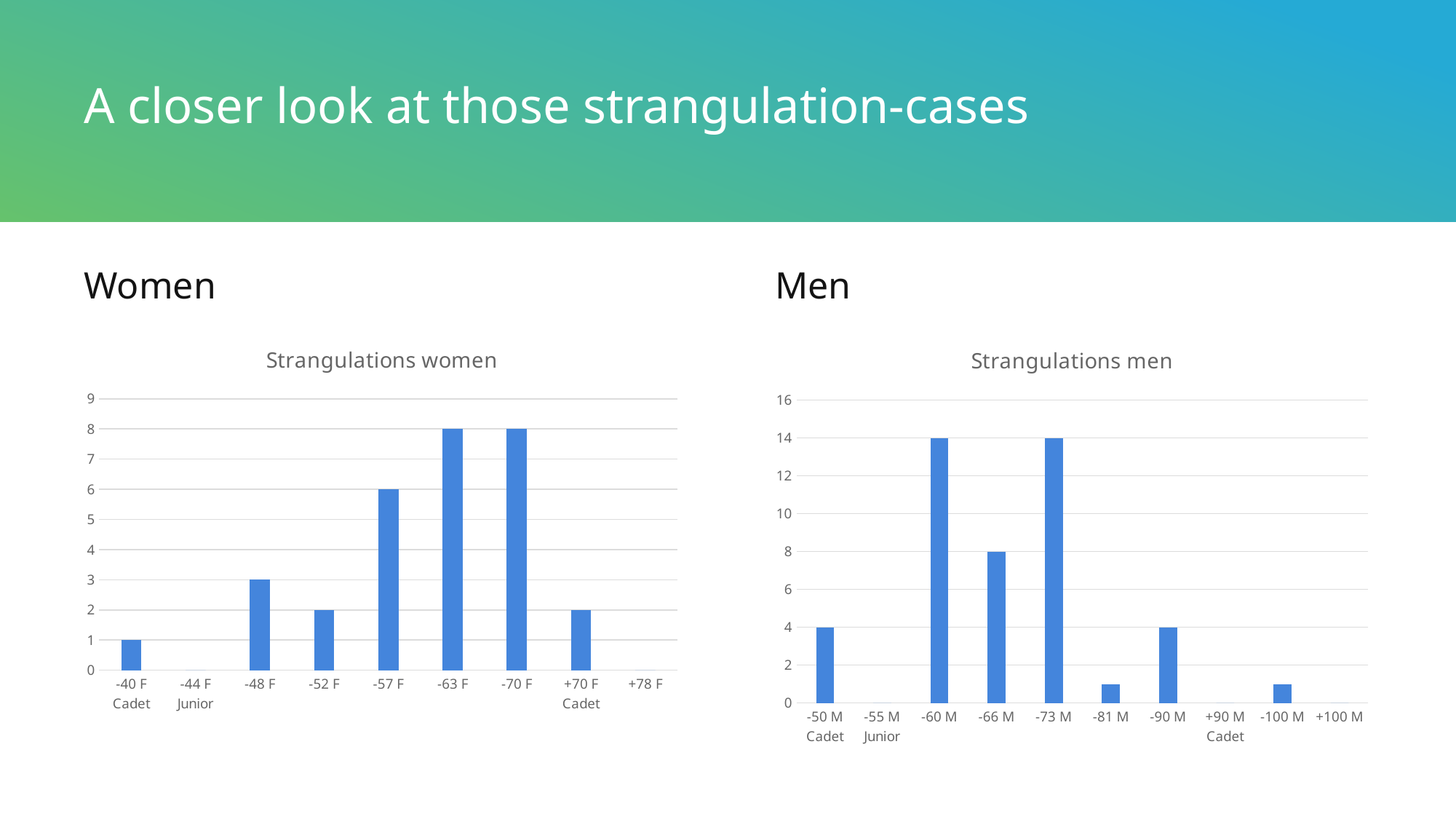
In the Strangulations women chart, what is the difference between the values for -63 F and -57 F? 2 In the Strangulations men chart, which is larger, the value for -60 M or the value for -66 M? -60 M In the Strangulations men chart, what is the difference between the values for -73 M and -90 M? 10 In the Strangulations men chart, what is the value for -66 M? 8 In the Strangulations men chart, is the value for -81 M greater or less than 2? less In the Strangulations men chart, what is the value for -50 M Cadet? 4 In the Strangulations men chart, how many categories are shown on the x axis? 10 In the Strangulations women chart, which category has the lowest non-zero value? -40 F Cadet In the Strangulations women chart, how many categories are shown on the x axis? 9 In the Strangulations women chart, what is the value for -57 F? 6 In the Strangulations women chart, what is the value for -48 F? 3 What type of chart is the Strangulations men chart? Bar chart